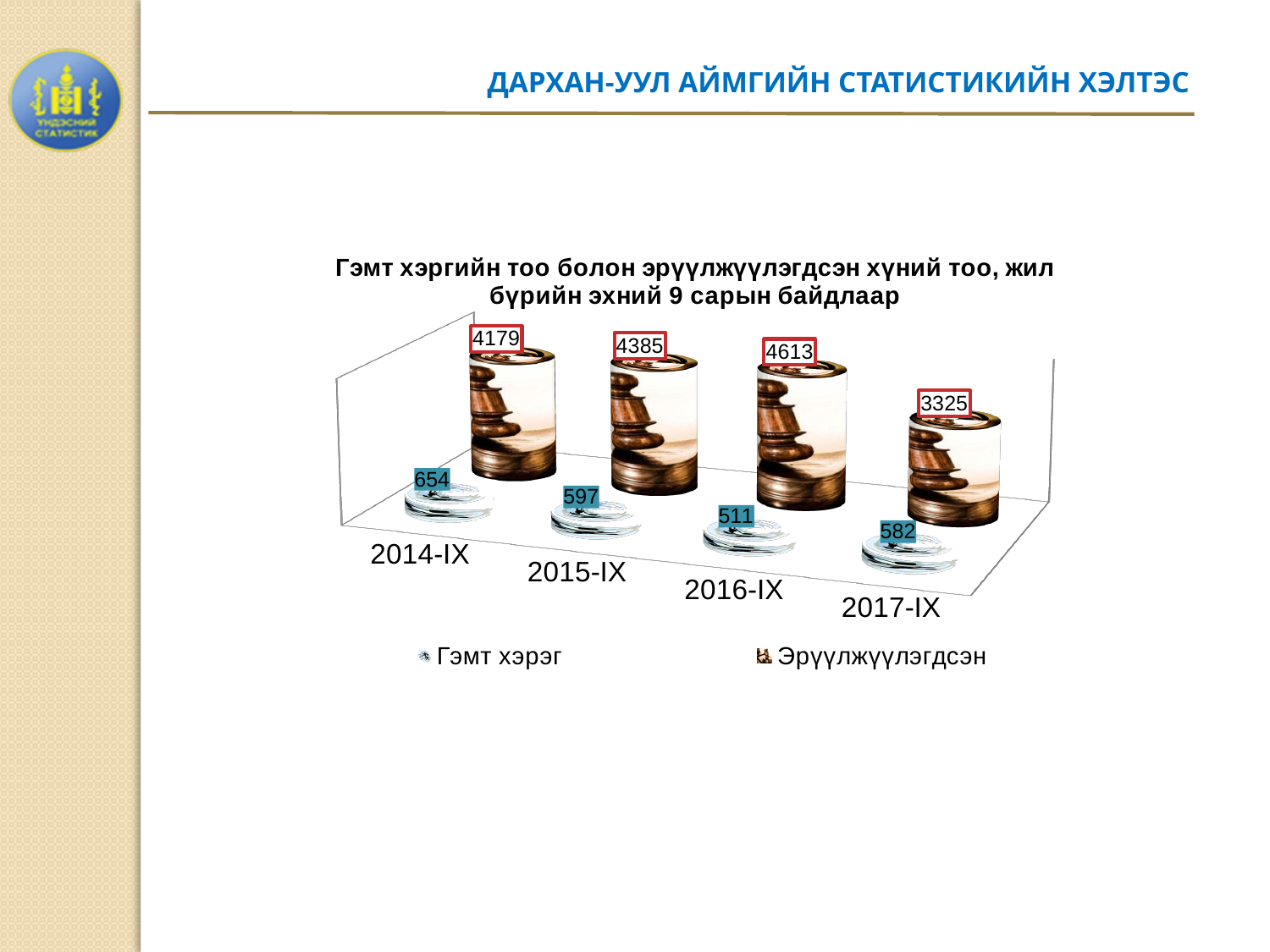
What is the value for Эрүүлжүүлэгдсэн in 2016-IX? 4613 What is the value for Гэмт хэрэг in 2017-IX? 582 What is the difference between the Гэмт хэрэг values for 2014-IX and 2015-IX? 57 In which year is the Гэмт хэрэг value lowest? 2016-IX How many years are shown on the x axis? 4 What is the difference between the Эрүүлжүүлэгдсэн values for 2016-IX and 2017-IX? 1288 How many series does the legend list? 2 Which is larger: the Гэмт хэрэг value for 2015-IX or for 2017-IX? 2015-IX In which year is the Эрүүлжүүлэгдсэн value highest? 2016-IX What kind of chart is shown on the slide? Bar chart What is the value for Эрүүлжүүлэгдсэн in 2015-IX? 4385 What is the value for Гэмт хэрэг in 2014-IX? 654